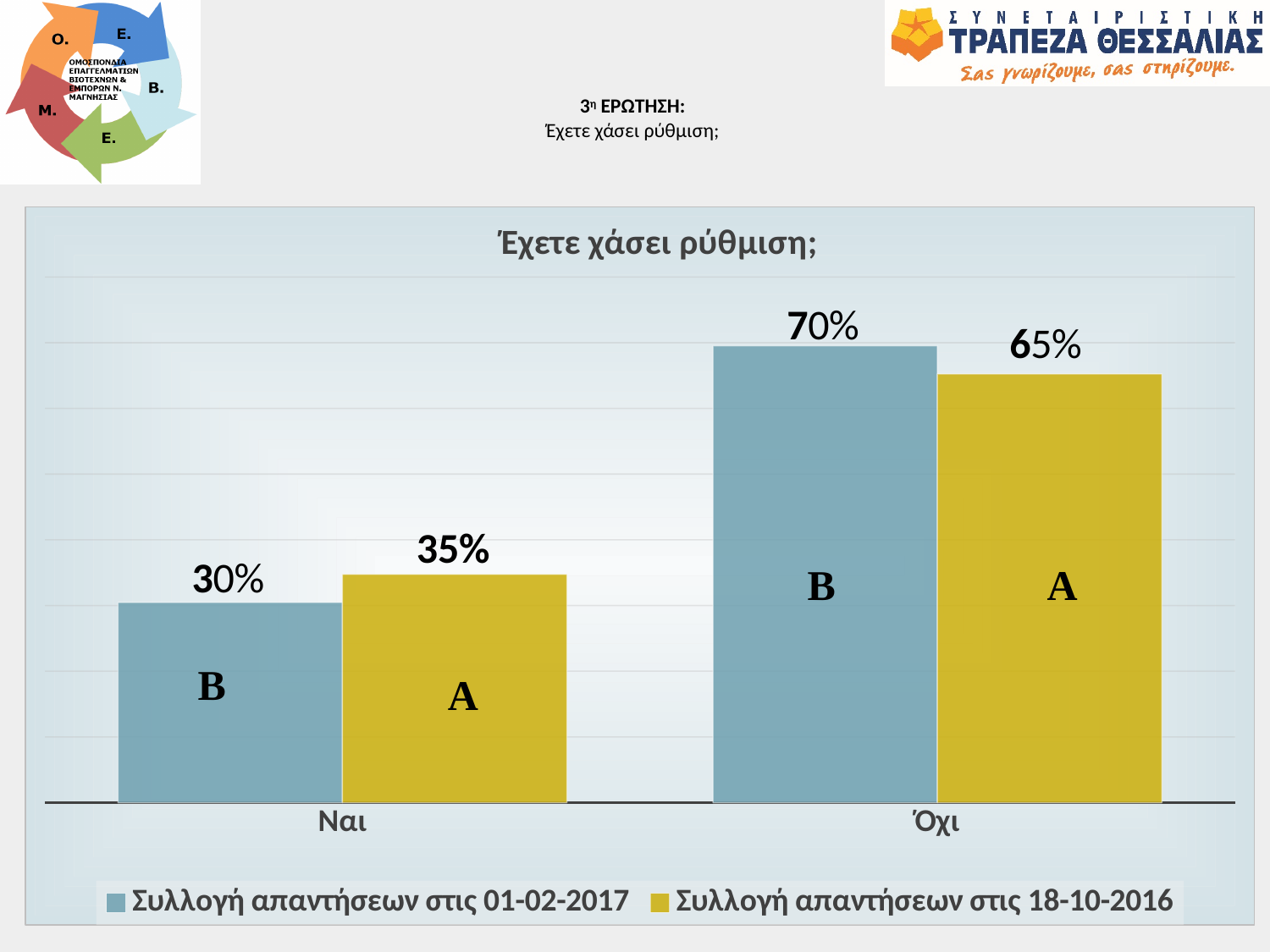
Which category has the lowest value in the series Συλλογή απαντήσεων στις 18-10-2016? Ναι What is the difference between the Όχι values of the two series? 5% What is the value for Όχι in the series Συλλογή απαντήσεων στις 18-10-2016? 65% What is the value for Όχι in the series Συλλογή απαντήσεων στις 01-02-2017? 70% For Ναι, which series has the larger value: Συλλογή απαντήσεων στις 01-02-2017 or Συλλογή απαντήσεων στις 18-10-2016? Συλλογή απαντήσεων στις 18-10-2016 Which category has the highest value in the series Συλλογή απαντήσεων στις 01-02-2017? Όχι What is the value for Ναι in the series Συλλογή απαντήσεων στις 01-02-2017? 30% How many series does the legend list? 2 What is the value for Ναι in the series Συλλογή απαντήσεων στις 18-10-2016? 35% What kind of chart is shown on the slide? bar chart What is the title of the chart? Έχετε χάσει ρύθμιση; How many categories are shown on the x axis? 2